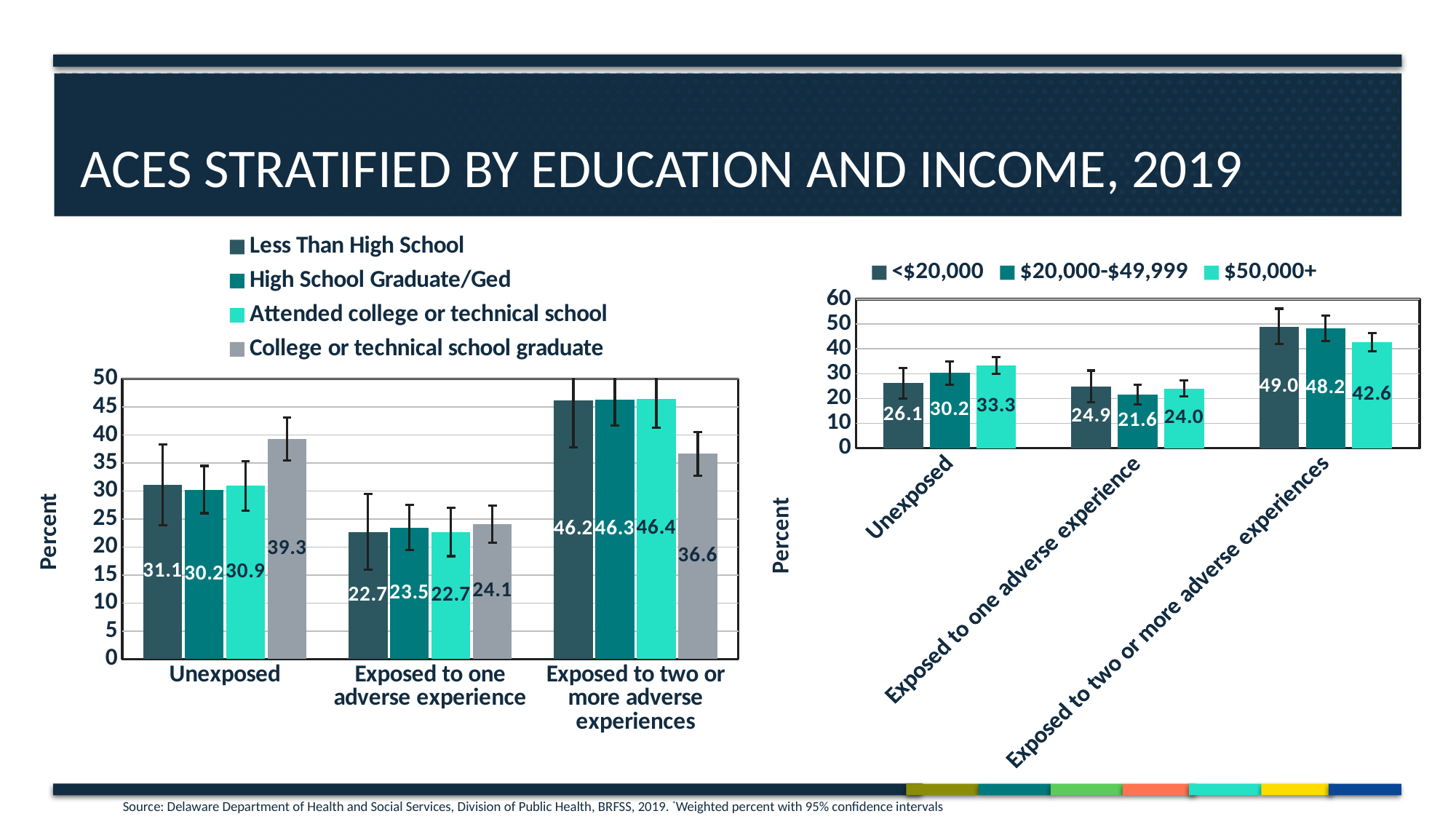
How many categories are shown on the x axis of the right chart? 3 How many series does the legend of the left chart list? 4 In the right chart, what is the value for $20,000-$49,999 in the Exposed to one adverse experience category? 21.6 In the left chart, which education group has the lowest value in the Exposed to two or more adverse experiences category? College or technical school graduate In the left chart, what is the value for Less Than High School in the Exposed to two or more adverse experiences category? 46.2 In the right chart, which income group has the highest value in the Exposed to two or more adverse experiences category? <$20,000 In the left chart, what is the difference between the College or technical school graduate values for Unexposed and Exposed to two or more adverse experiences? 2.7 What kind of chart is the right chart? bar chart In the right chart, what is the value for $50,000+ in the Unexposed category? 33.3 In the right chart, what is the difference between the <$20,000 and $50,000+ values in the Exposed to two or more adverse experiences category? 6.4 In the left chart, what is the value for College or technical school graduate in the Unexposed category? 39.3 In the right chart, is the value for <$20,000 in the Unexposed category larger or smaller than the value for $50,000+ in the same category? smaller